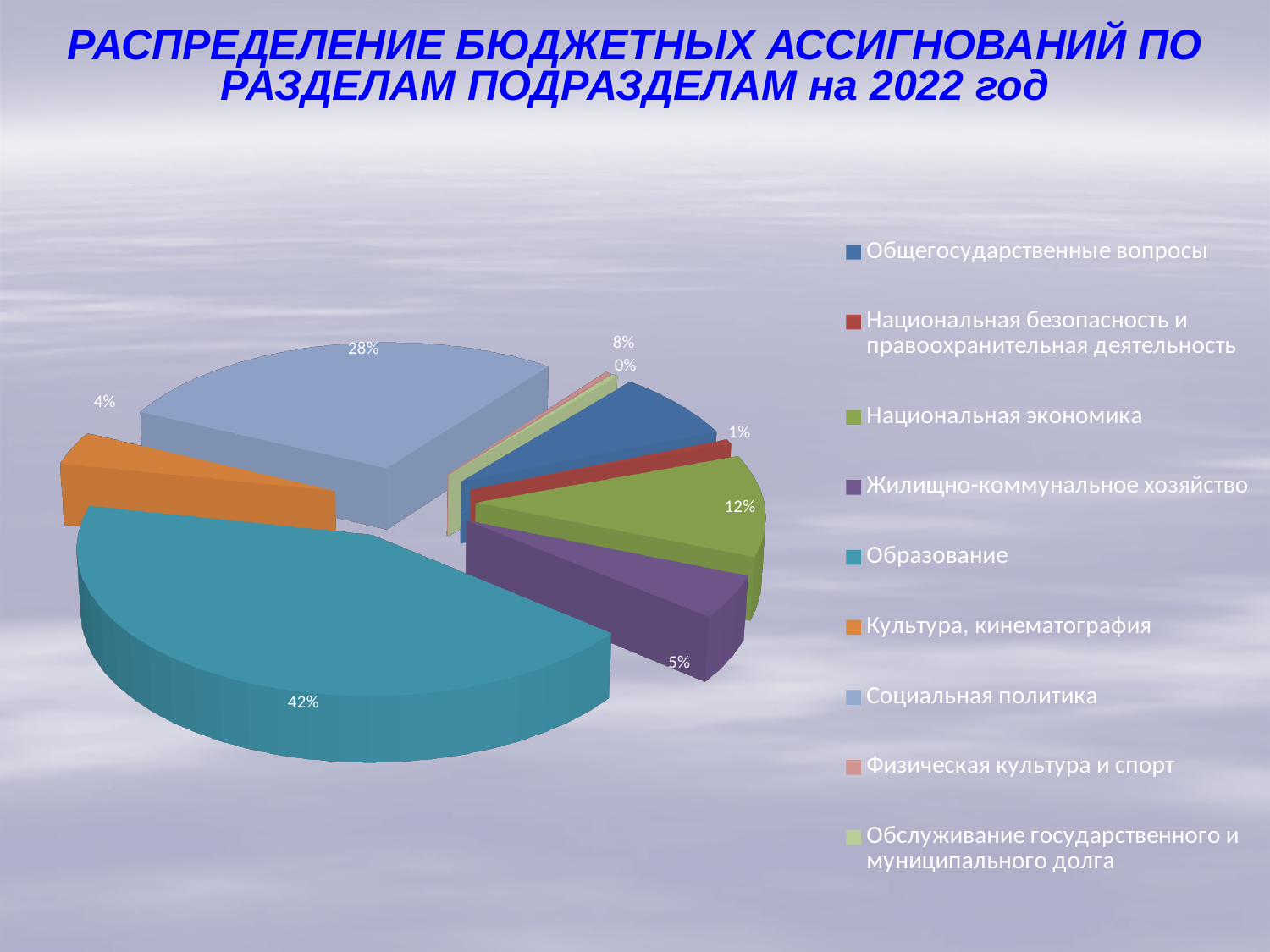
What is the difference in percentage points between Образование and Социальная политика? 14 What share is shown for Культура, кинематография? 4% What share is shown for Социальная политика? 28% What percentage is shown for Жилищно-коммунальное хозяйство? 5% What type of chart is shown on the slide? Pie chart What share of the budget goes to Образование? 42% What share is shown for Общегосударственные вопросы? 8% What percentage is shown for Национальная экономика? 12% How many categories does the legend list? 9 What year does the chart title refer to? 2022 Which is larger: the share for Национальная экономика or the share for Жилищно-коммунальное хозяйство? Национальная экономика Which category has the largest slice of the pie? Образование